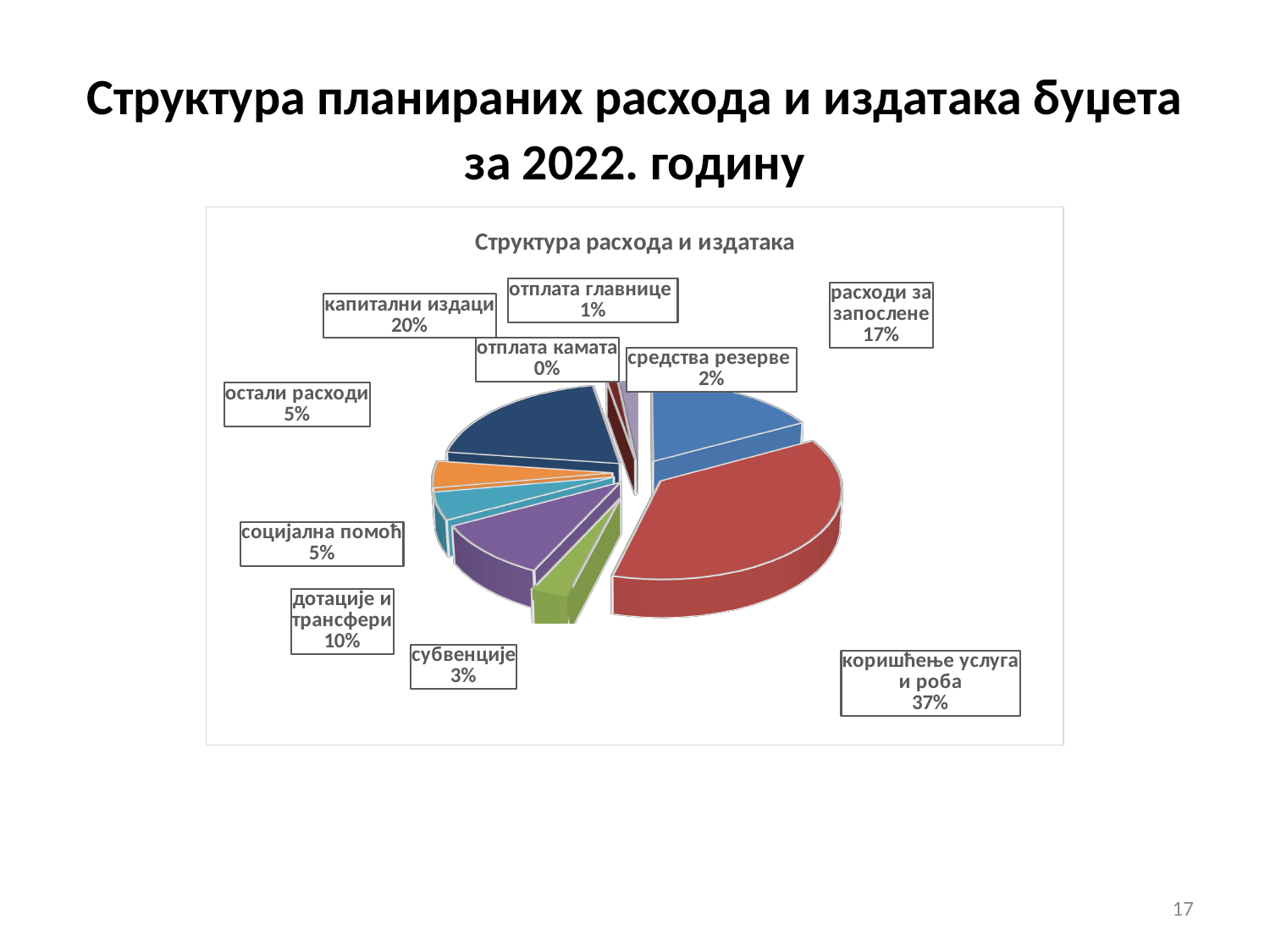
What share of the pie is коришћење услуга и роба? 37% What is the value shown for расходи за запослене? 17% How many categories are shown in the pie chart? 10 What is the difference in percentage points between коришћење услуга и роба and капитални издаци? 17 What is the title of the chart? Структура расхода и издатака Which category has the smallest share of the pie? отплата камата Which is larger, the share for субвенције or the share for средства резерве? субвенције What kind of chart is shown on the slide? pie chart What share of the pie is капитални издаци? 20% What is the value shown for отплата главнице? 1% Which category has the largest share of the pie? коришћење услуга и роба What is the value shown for дотације и трансфери? 10%